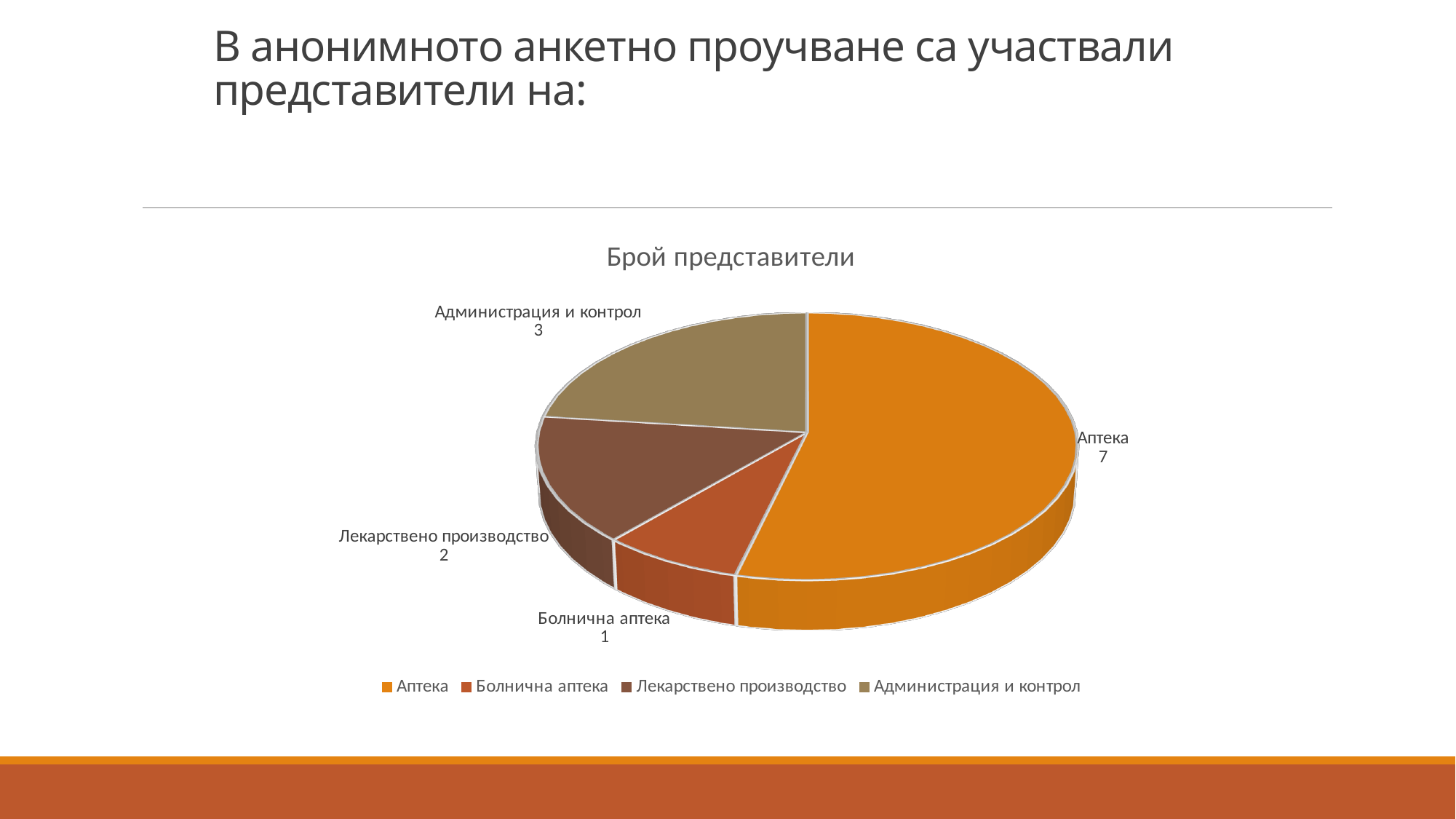
What is the difference between the values for Аптека and Администрация и контрол? 4 How many categories does the pie chart have? 4 What is the value for Болнична аптека? 1 Which is larger, the value for Лекарствено производство or the value for Администрация и контрол? Администрация и контрол What is the value for Аптека? 7 What is the title of the chart? Брой представители What share of the total does the Аптека slice represent? 7/13 Which category has the lowest value? Болнична аптека What is the value for Администрация и контрол? 3 What type of chart is shown on the slide? pie chart What is the value for Лекарствено производство? 2 Which category has the highest value? Аптека